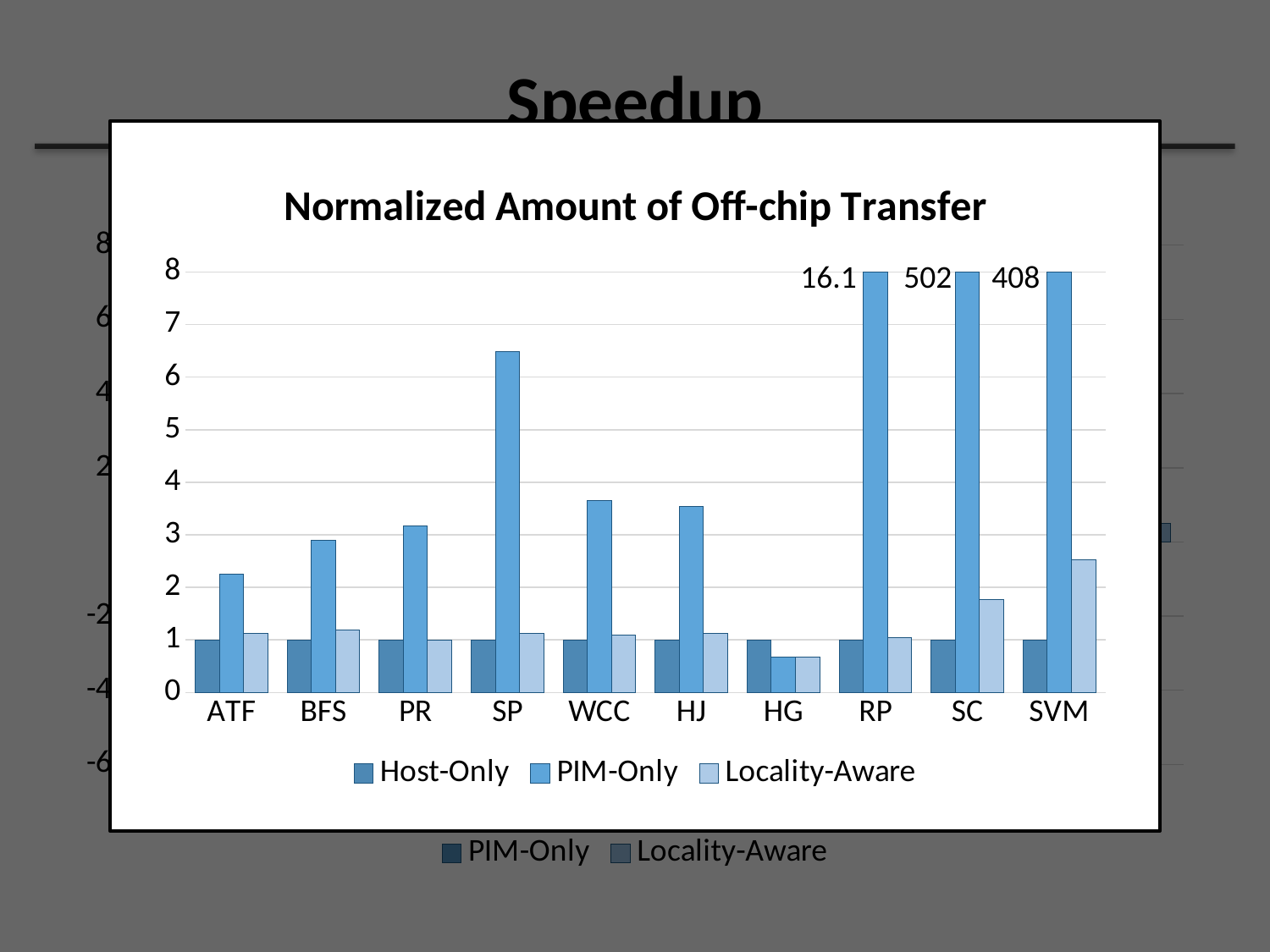
In the 'Normalized Amount of Off-chip Transfer' chart, is the PIM-Only value for HG greater or less than 1? less What kind of chart is the 'Normalized Amount of Off-chip Transfer' chart? bar chart In the 'Normalized Amount of Off-chip Transfer' chart, which category has the lowest PIM-Only value? HG In the 'Normalized Amount of Off-chip Transfer' chart, is the PIM-Only value for SP greater or less than 6? greater How many categories are shown on the x axis of the 'Normalized Amount of Off-chip Transfer' chart? 10 In the 'Normalized Amount of Off-chip Transfer' chart, which is larger: the Locality-Aware value for SVM or the Locality-Aware value for SC? SVM In the 'Normalized Amount of Off-chip Transfer' chart, which category has the highest PIM-Only value? SC In the 'Normalized Amount of Off-chip Transfer' chart, what is the PIM-Only value for RP? 16.1 How many series does the legend of the 'Normalized Amount of Off-chip Transfer' chart list? 3 In the 'Normalized Amount of Off-chip Transfer' chart, what is the PIM-Only value for SC? 502 In the 'Normalized Amount of Off-chip Transfer' chart, what is the difference between the PIM-Only values for SC and SVM? 94 In the 'Normalized Amount of Off-chip Transfer' chart, what is the PIM-Only value for SVM? 408